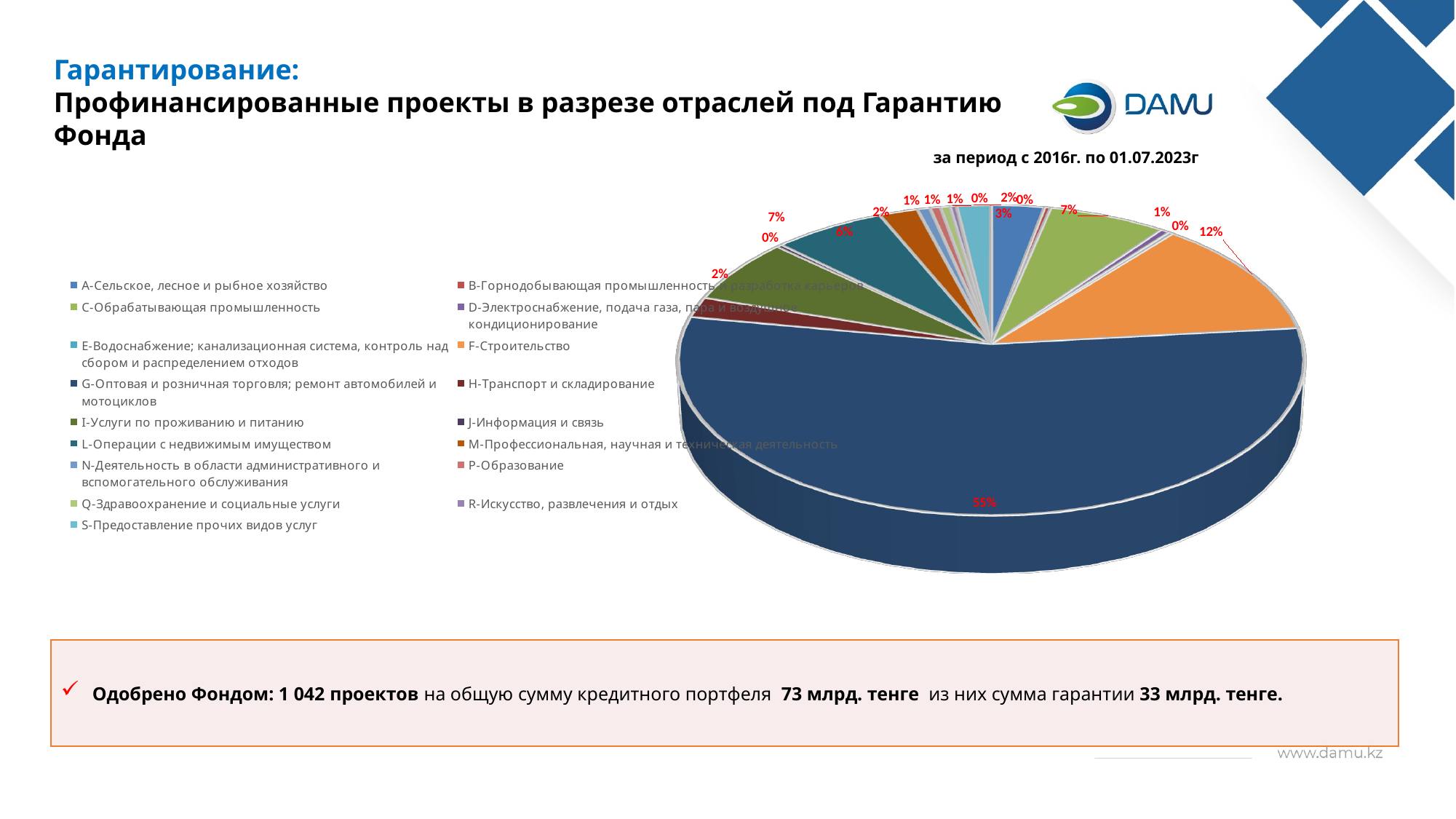
Which is larger: the share for G-Оптовая и розничная торговля or the share for F-Строительство? G-Оптовая и розничная торговля By how many percentage points does the share of G-Оптовая и розничная торговля exceed the share of F-Строительство? 43 percentage points What period does the chart cover, according to the text above it? за период с 2016г. по 01.07.2023г What colour is the slice for G-Оптовая и розничная торговля; ремонт автомобилей и мотоциклов? dark blue How many sectors are listed in the chart legend? 17 What share of the pie does C-Обрабатывающая промышленность have? 7% What share of the pie does G-Оптовая и розничная торговля; ремонт автомобилей и мотоциклов have? 55% What share of the pie does F-Строительство have? 12% What kind of chart is shown on the slide? pie chart Which sector has the largest share of the pie? G-Оптовая и розничная торговля; ремонт автомобилей и мотоциклов